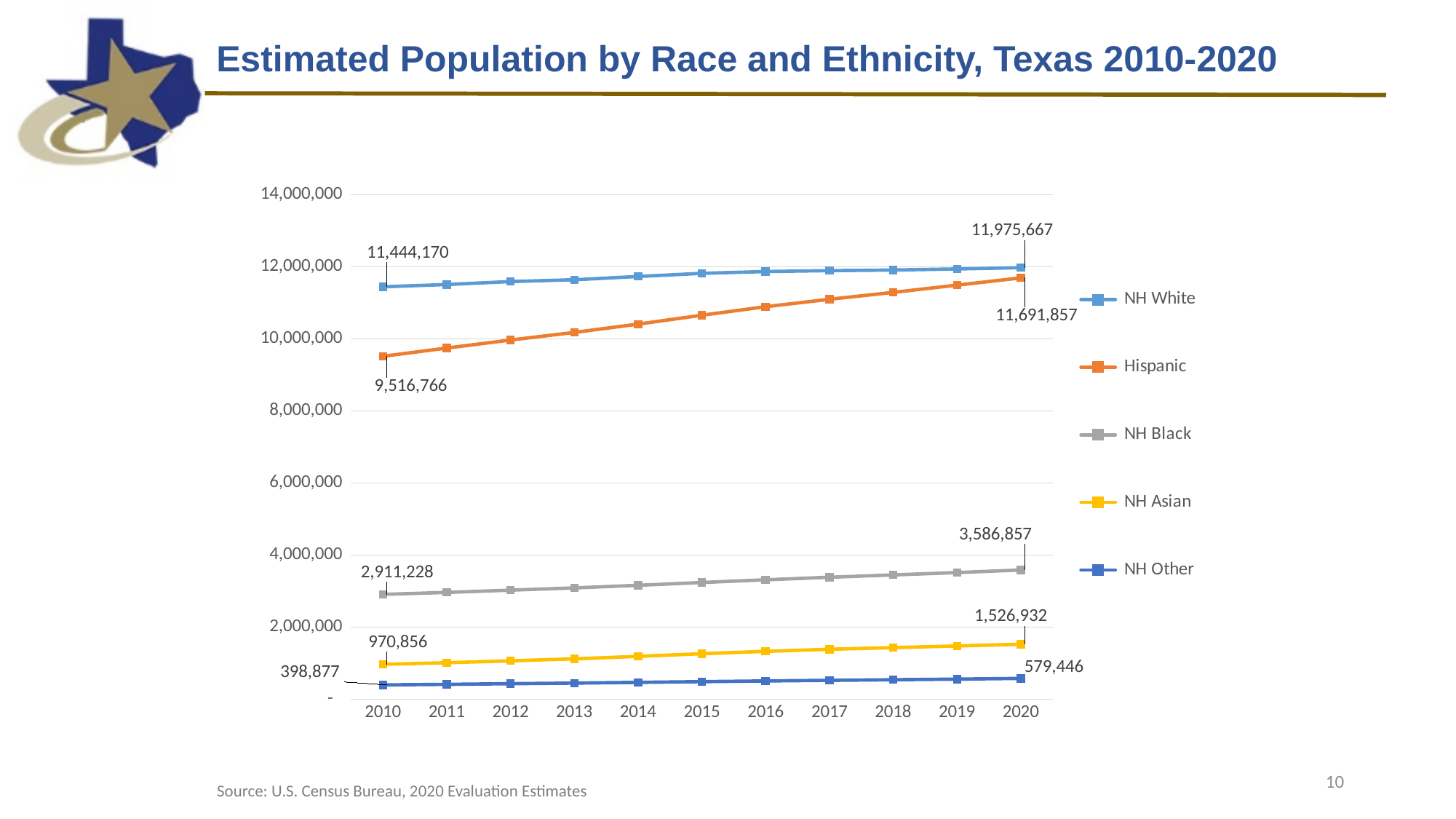
What is the difference between the NH White and Hispanic populations in 2020? 283,810 What was the estimated NH Asian population in 2010? 970,856 Which group had the smallest estimated population in 2010? NH Other What was the estimated NH White population in Texas in 2010? 11,444,170 What was the estimated NH Other population in 2020? 579,446 What was the estimated Hispanic population in Texas in 2020? 11,691,857 Which was larger in 2020, the NH Asian population or the NH Other population? NH Asian How many years are shown on the x axis? 11 By how much did the Hispanic population grow from 2010 to 2020? 2,175,091 Which group had the largest estimated population in 2020? NH White Is the Hispanic population in 2014 greater or less than 10,000,000? greater How many series does the legend list? 5